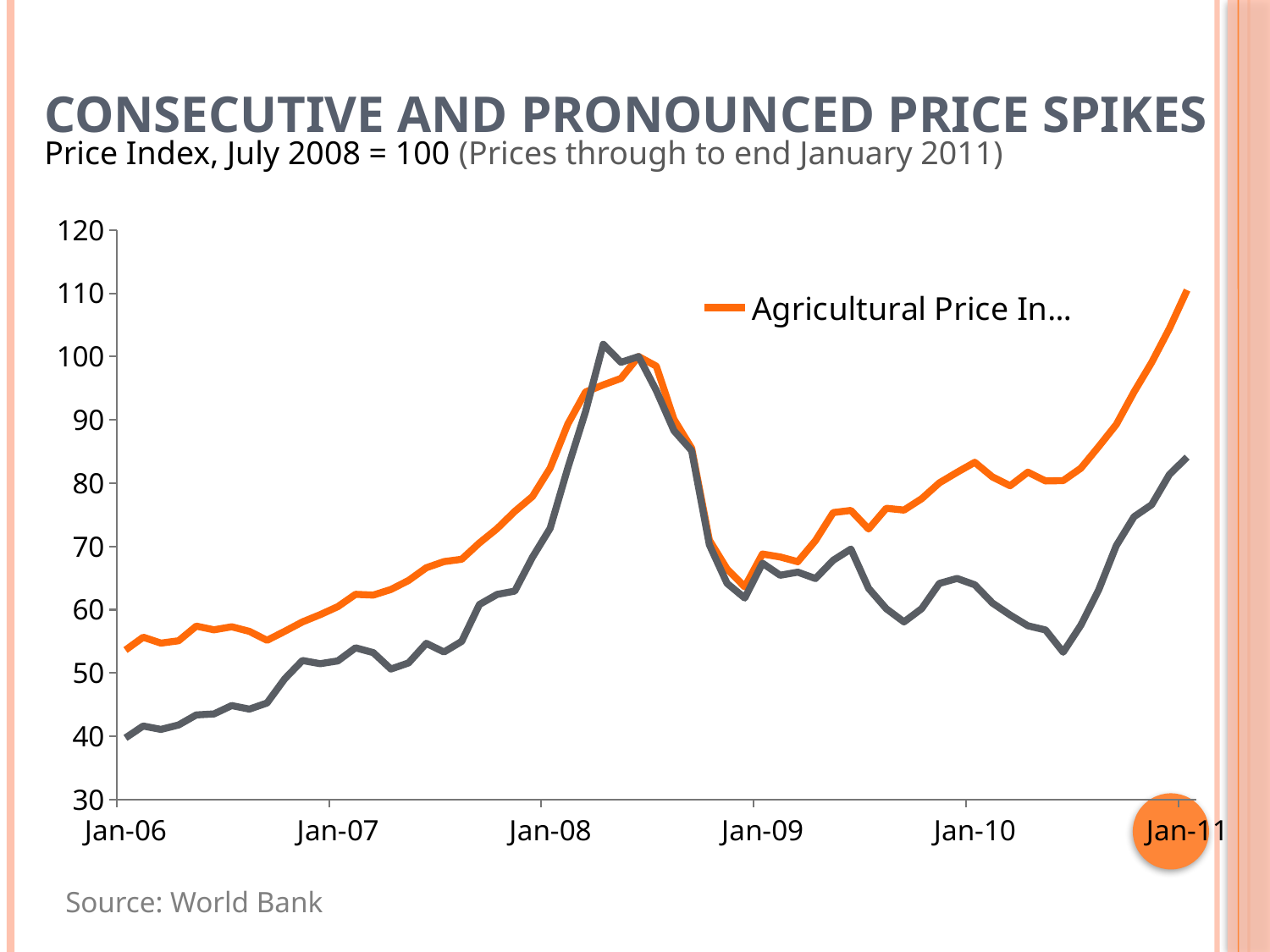
At Jan-11, which line is higher: the orange Agricultural Price Index line or the grey line? the orange Agricultural Price Index line What is the title of the chart on the slide? CONSECUTIVE AND PRONOUNCED PRICE SPIKES Is the value of the grey line at Jan-10 greater or less than 70? less Is the value of the orange Agricultural Price Index line at Jan-11 greater or less than 100? greater Is the value of the grey line at Jan-06 greater or less than 50? less What is the source cited for the chart? World Bank Does the orange Agricultural Price Index line rise or fall between Jan-10 and Jan-11? rise How many lines are plotted on the chart? 2 What kind of chart is shown on the slide? line chart How many year labels are shown on the x axis? 6